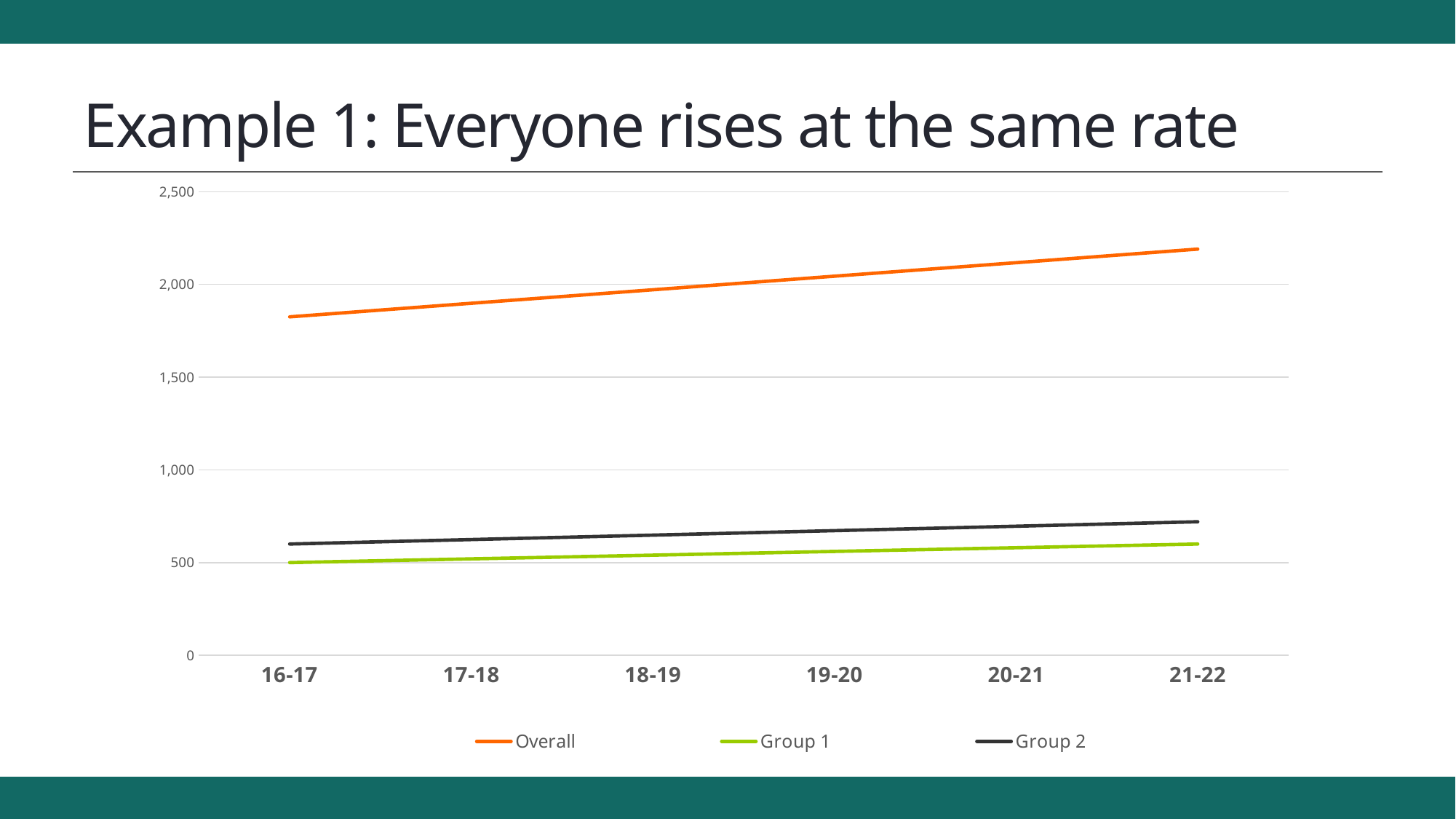
Is the value for Group 2 at 21-22 greater or less than 1,000? less Which series has the highest values across the chart? Overall What is the title of the slide containing the chart? Example 1: Everyone rises at the same rate How many series does the legend list? 3 Is the value for Group 1 at 21-22 greater or less than 500? greater How many points are plotted along the x axis for each series? 6 Is the value for Overall at 21-22 greater or less than 2,000? greater Does the Overall series rise or fall from 16-17 to 21-22? rise Which series has the lowest values across the chart? Group 1 At 16-17, which is larger: Group 1 or Group 2? Group 2 What kind of chart is shown on the slide? line chart